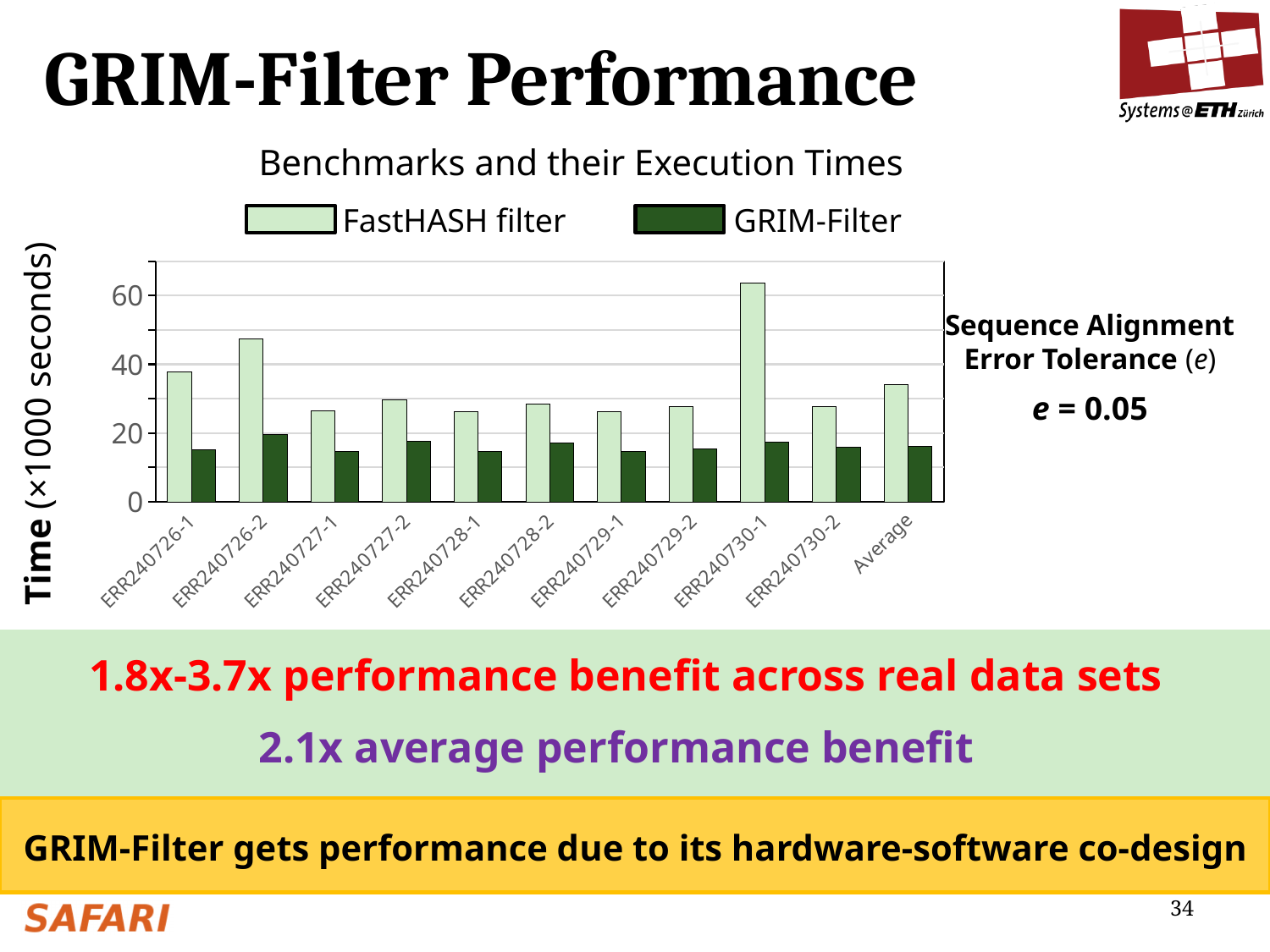
How many series does the legend list? 2 Is the GRIM-Filter value for ERR240726-1 greater or less than 20? less Is the FastHASH filter value for ERR240730-1 greater or less than 60? greater What is the title of the chart? Benchmarks and their Execution Times Is the FastHASH filter value for ERR240726-2 greater or less than 40? greater Which category has the highest GRIM-Filter execution time? ERR240726-2 Which is larger, the FastHASH filter value for ERR240726-2 or for ERR240727-1? ERR240726-2 What is the label of the y axis? Time (×1000 seconds) Which category has the highest FastHASH filter execution time? ERR240730-1 What kind of chart is shown on the slide? bar chart How many categories are shown on the x axis? 11